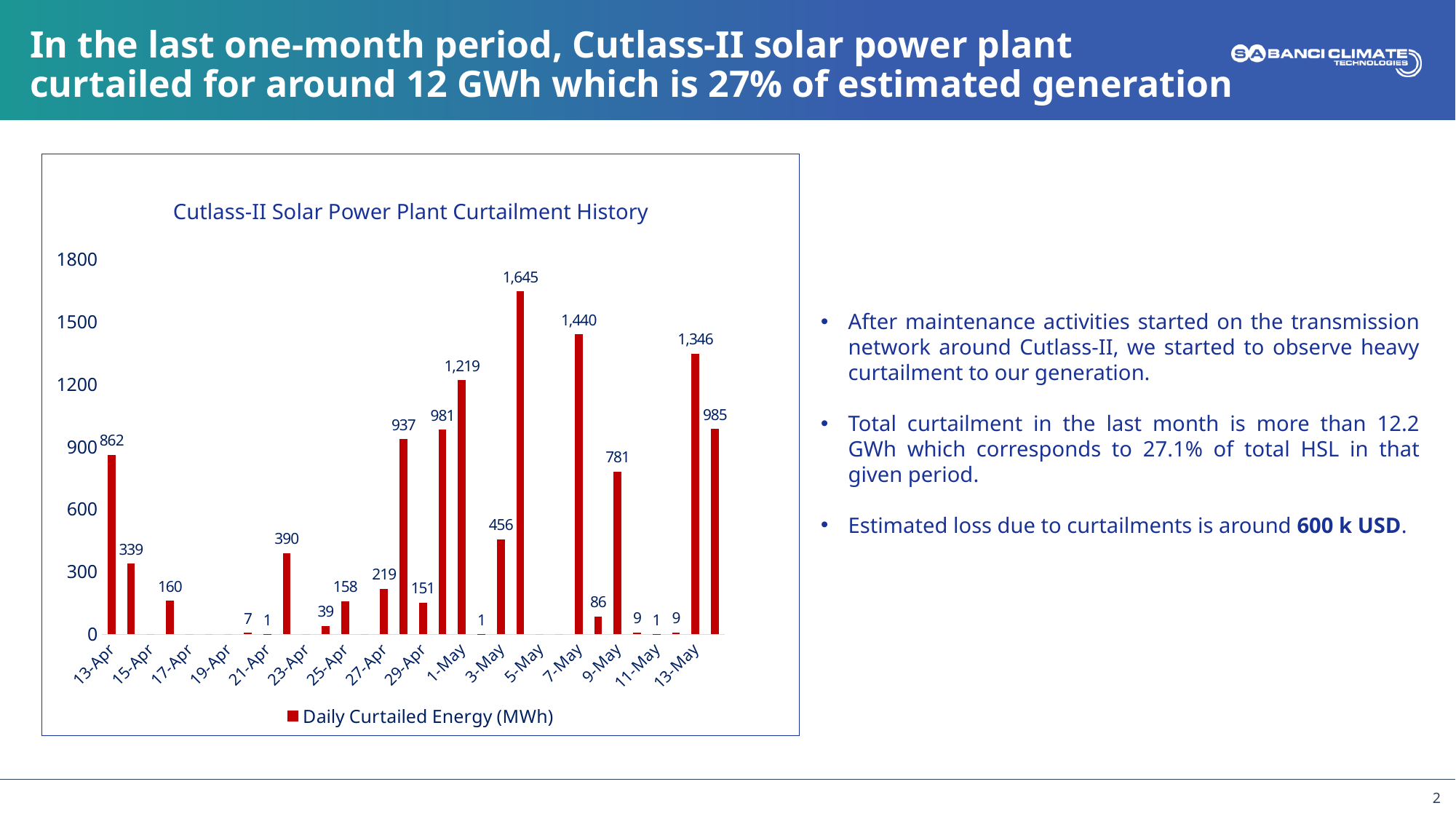
How many date labels are shown on the x axis? 16 What type of chart is shown on the slide? bar chart How many series does the legend list? 1 Which date has the larger daily curtailed energy, 13-Apr or 13-May? 13-May What is the highest daily curtailed energy value shown in the chart? 1,645 What series does the chart legend list? Daily Curtailed Energy (MWh) What is the difference between the last two bars, labeled 1,346 and 985? 361 What is the daily curtailed energy value for 13-Apr? 862 What is the title of the chart? Cutlass-II Solar Power Plant Curtailment History Is the value for 13-Apr greater or less than 900? less What is the maximum value shown on the y axis? 1800 What is the difference between the highest bar (1,645) and the second highest bar (1,440)? 205